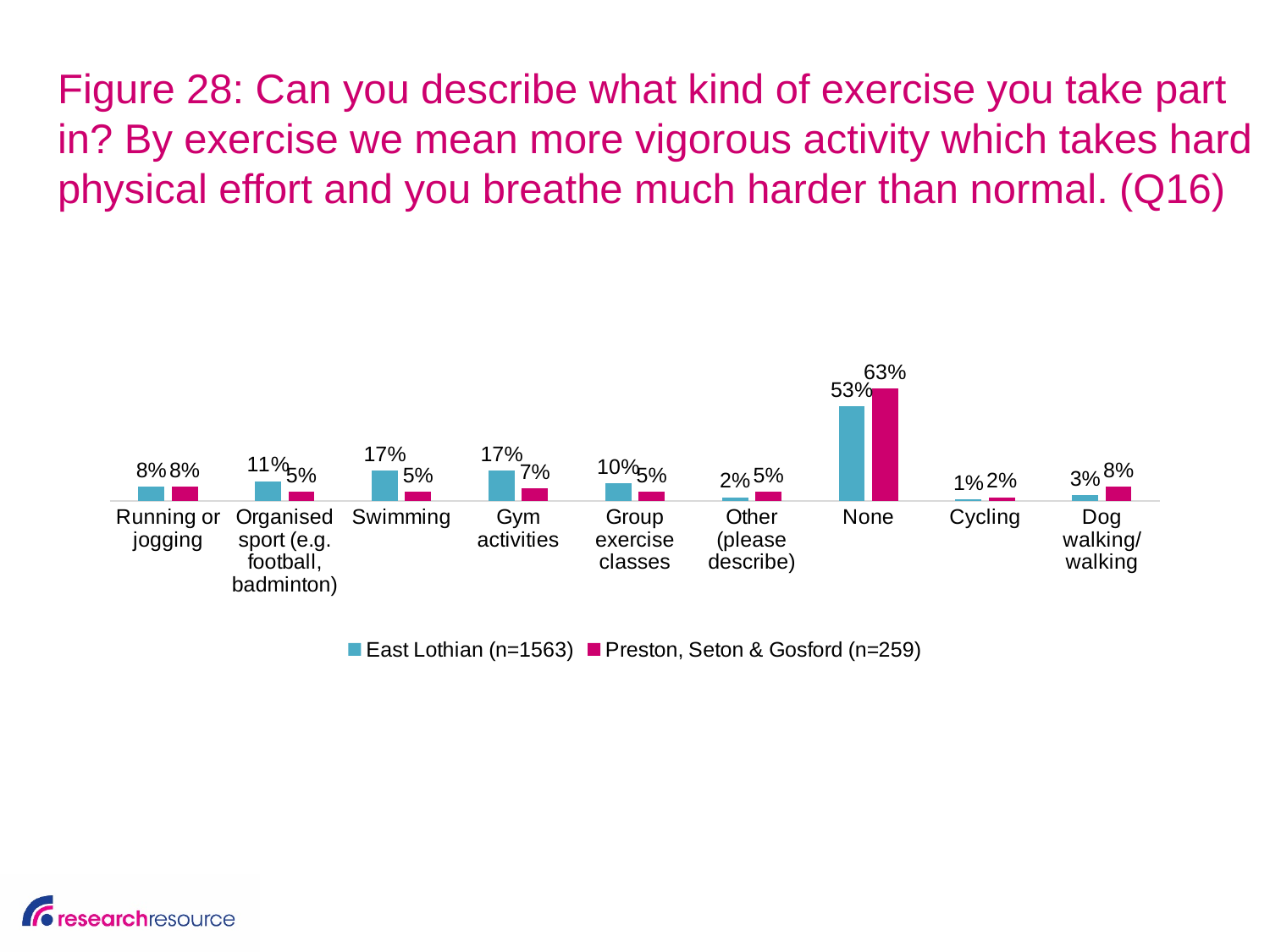
What is the value for Swimming in the Preston, Seton & Gosford (n=259) series? 5% Which category has the highest value in the Preston, Seton & Gosford (n=259) series? None What is the value for None in the East Lothian (n=1563) series? 53% Which series has the larger value for Other (please describe)? Preston, Seton & Gosford (n=259) What kind of chart is shown on the slide? Bar chart Which series has the larger value for Gym activities? East Lothian (n=1563) What is the difference between the Preston, Seton & Gosford (n=259) and East Lothian (n=1563) values for None? 10% How many categories are shown on the x axis? 9 What is the difference between the East Lothian (n=1563) and Preston, Seton & Gosford (n=259) values for Swimming? 12% Which category has the lowest value in the East Lothian (n=1563) series? Cycling What is the value for Dog walking/ walking in the Preston, Seton & Gosford (n=259) series? 8% How many series does the legend list? 2